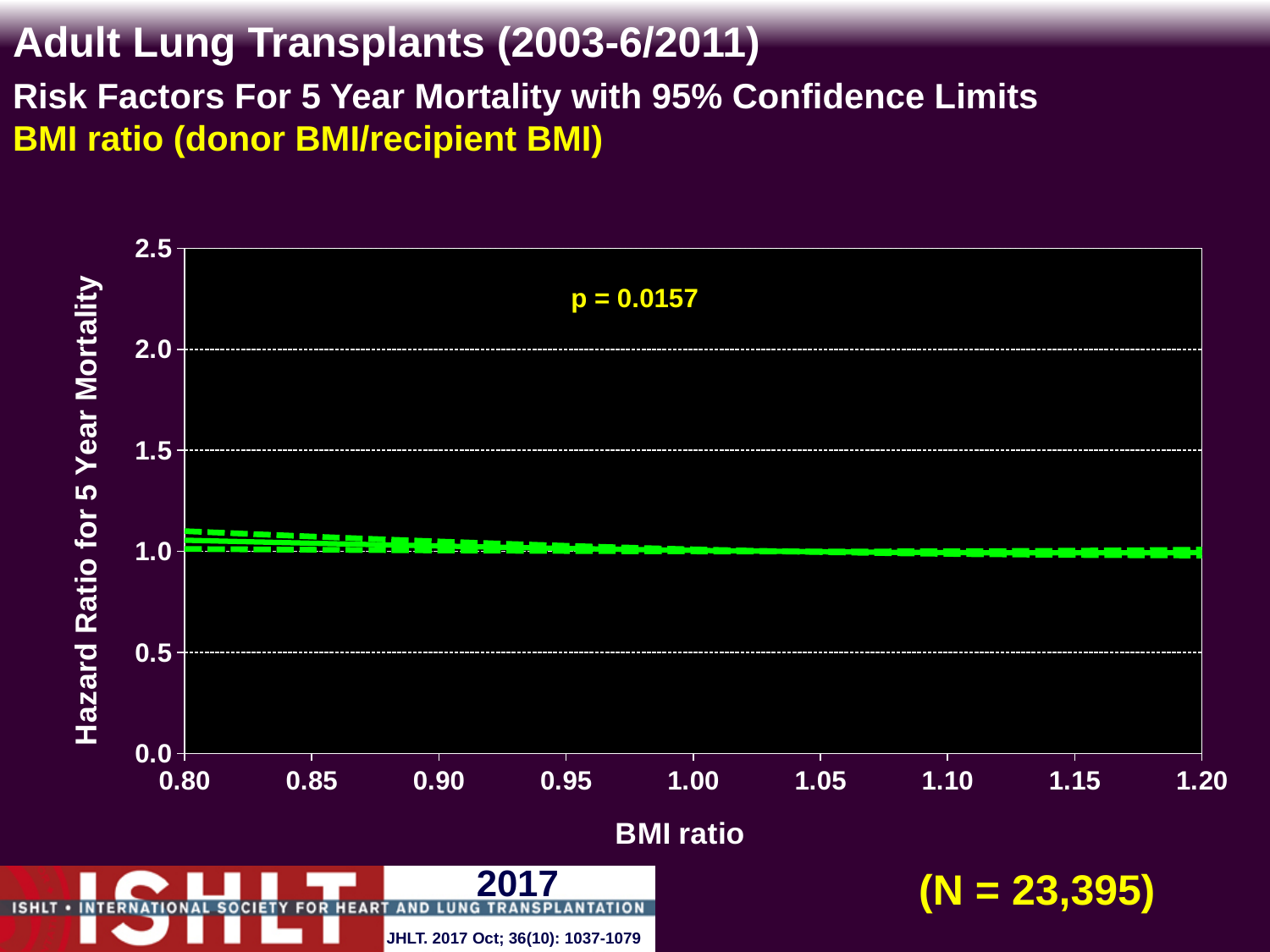
How many tick labels are shown on the x axis? 9 What is the sample size (N) shown on the slide? 23,395 Is the hazard ratio at a BMI ratio of 0.80 greater or less than 1.5? less How many tick labels are shown on the y axis? 6 Is the hazard ratio at a BMI ratio of 1.20 greater or less than 0.5? greater What is the highest value labelled on the y axis? 2.5 Is the hazard ratio at a BMI ratio of 1.00 greater or less than 2.0? less Does the hazard ratio rise or fall as the BMI ratio increases from 0.80 to 1.20? fall Which has the higher hazard ratio: a BMI ratio of 0.80 or a BMI ratio of 1.20? 0.80 What is the p-value printed on the chart? p = 0.0157 What kind of chart is shown on the slide? line chart